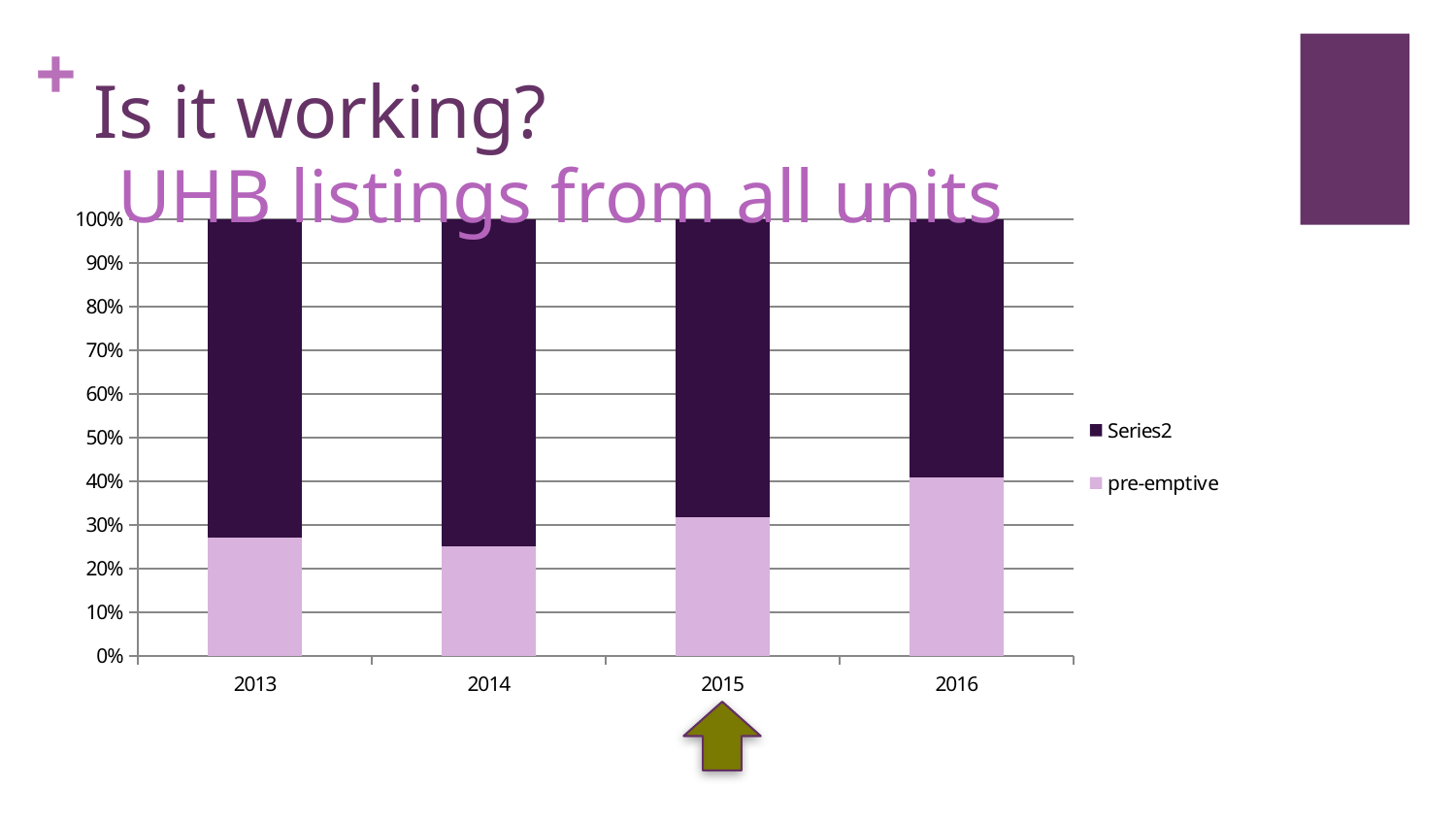
What is the total height of each stacked bar? 100% What is the title of the chart? UHB listings from all units Does the pre-emptive share rise or fall from 2014 to 2016? rise Which year has the highest pre-emptive share? 2016 How many years are shown on the x axis? 4 Is the pre-emptive value for 2014 greater or less than 30%? less What kind of chart is shown on the slide? stacked bar chart Is the pre-emptive value for 2015 greater or less than 30%? greater What are the two series named in the legend? Series2 and pre-emptive Which is larger, the pre-emptive share in 2013 or in 2016? 2016 How many series does the legend list? 2